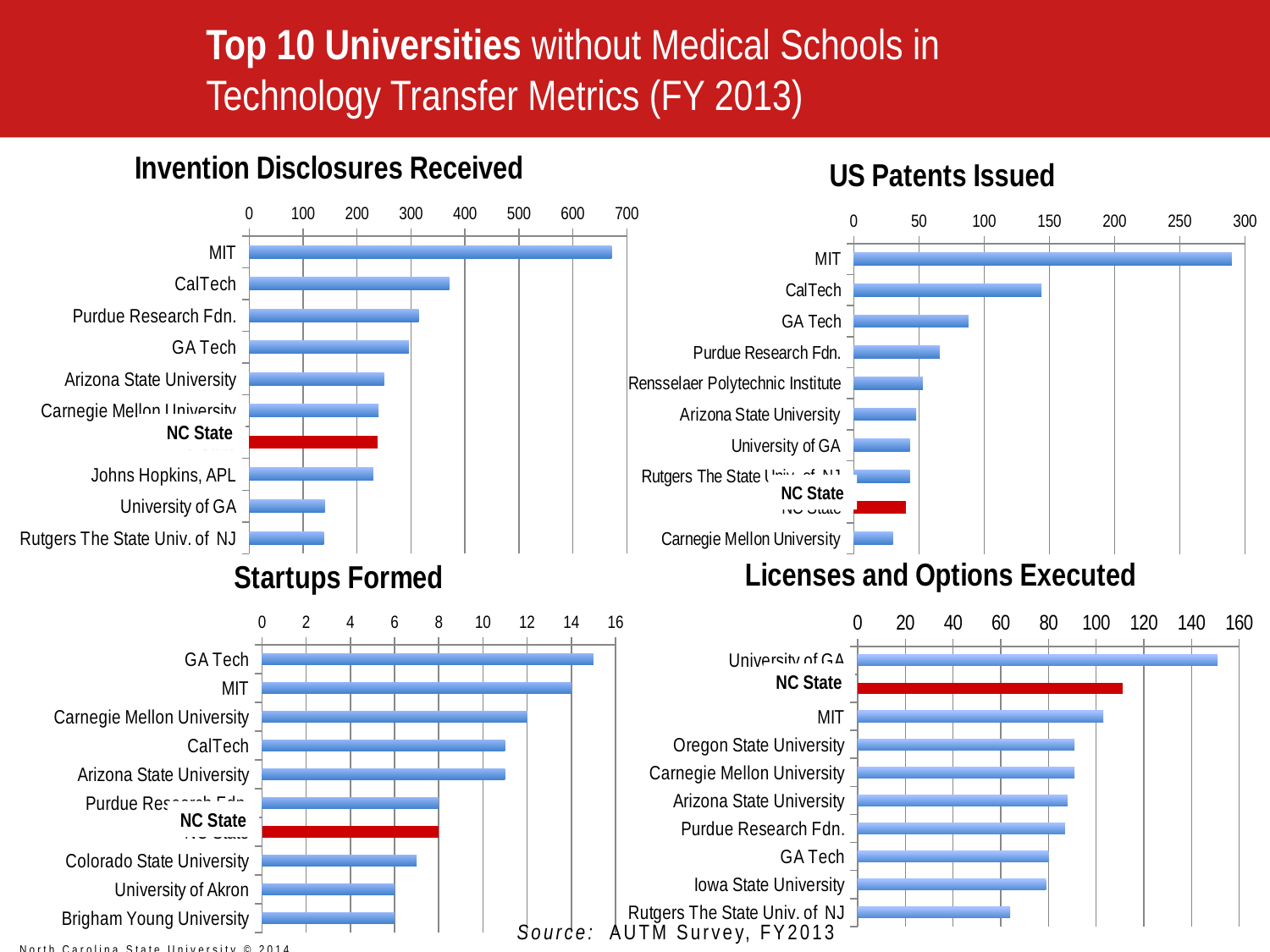
In the Licenses and Options Executed chart, is the value for NC State greater or less than 100? greater In the Invention Disclosures Received chart, which university has the highest value? MIT In the Licenses and Options Executed chart, which university has the highest value? University of GA In the US Patents Issued chart, which university has the lowest value? Carnegie Mellon University In the Startups Formed chart, is the value for GA Tech greater or less than 12? greater In the US Patents Issued chart, which university has the highest value? MIT In the US Patents Issued chart, is the value for CalTech greater or less than 100? greater In the Licenses and Options Executed chart, which university has the lowest value? Rutgers The State Univ. of NJ What type of chart is the Startups Formed chart? bar chart In the Invention Disclosures Received chart, which is larger, the value for CalTech or the value for University of GA? CalTech How many universities are shown in the Invention Disclosures Received chart? 10